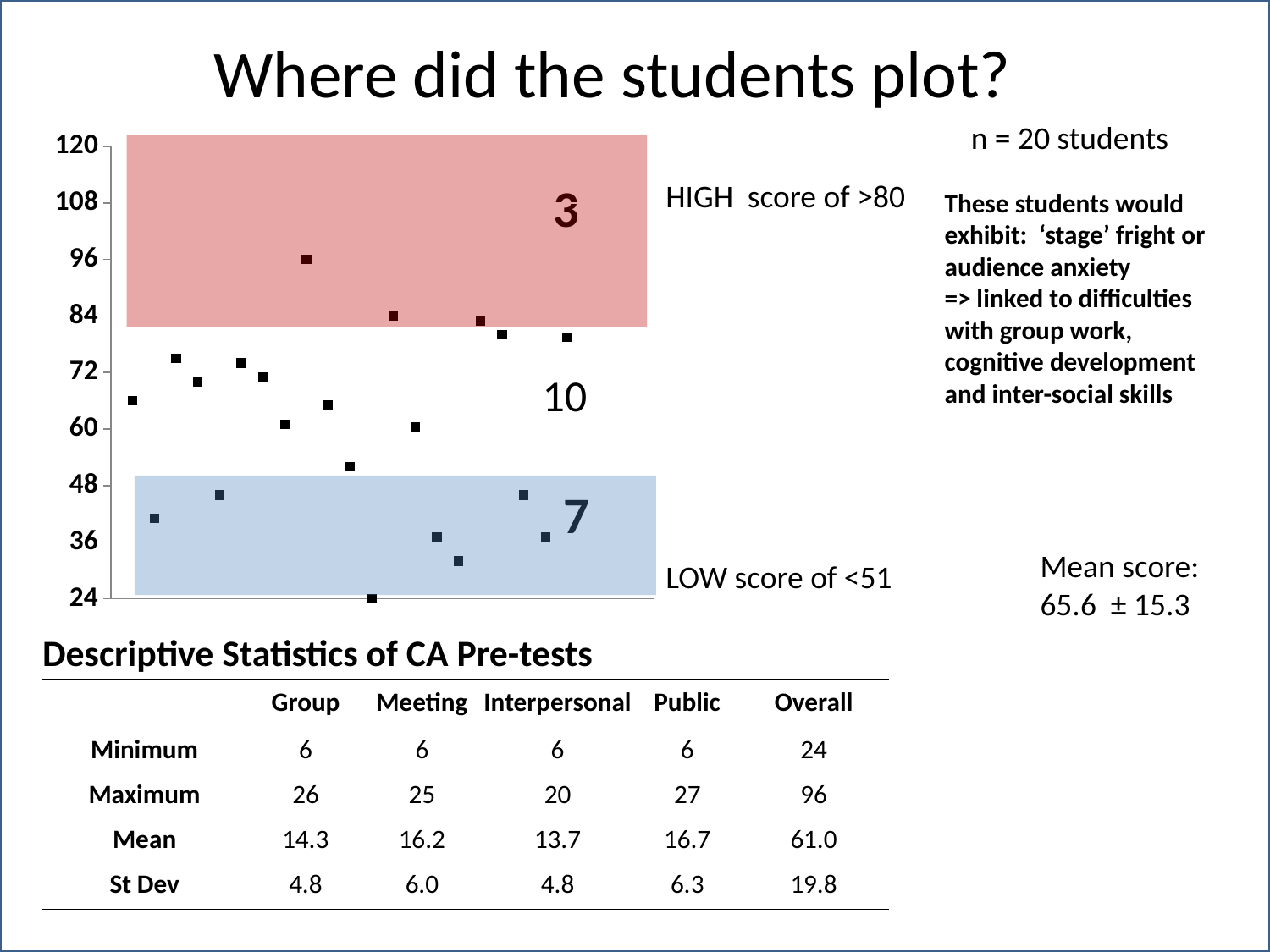
How many students fall in the red HIGH score region of the chart? 3 What is the maximum value shown on the chart's y axis? 120 What colour is the shaded region marking HIGH scores of >80 on the chart? red How many students fall between the HIGH and LOW regions of the chart? 10 What kind of chart is shown on the slide? scatter plot What is the lowest value plotted on the chart? 24 How many students fall in the blue LOW score region of the chart? 7 What is the difference between the highest and lowest plotted values on the chart? 72 Which region of the chart contains more students, the HIGH region or the LOW region? LOW region Is the highest plotted point on the chart greater or less than 84? greater What is the highest value plotted on the chart? 96